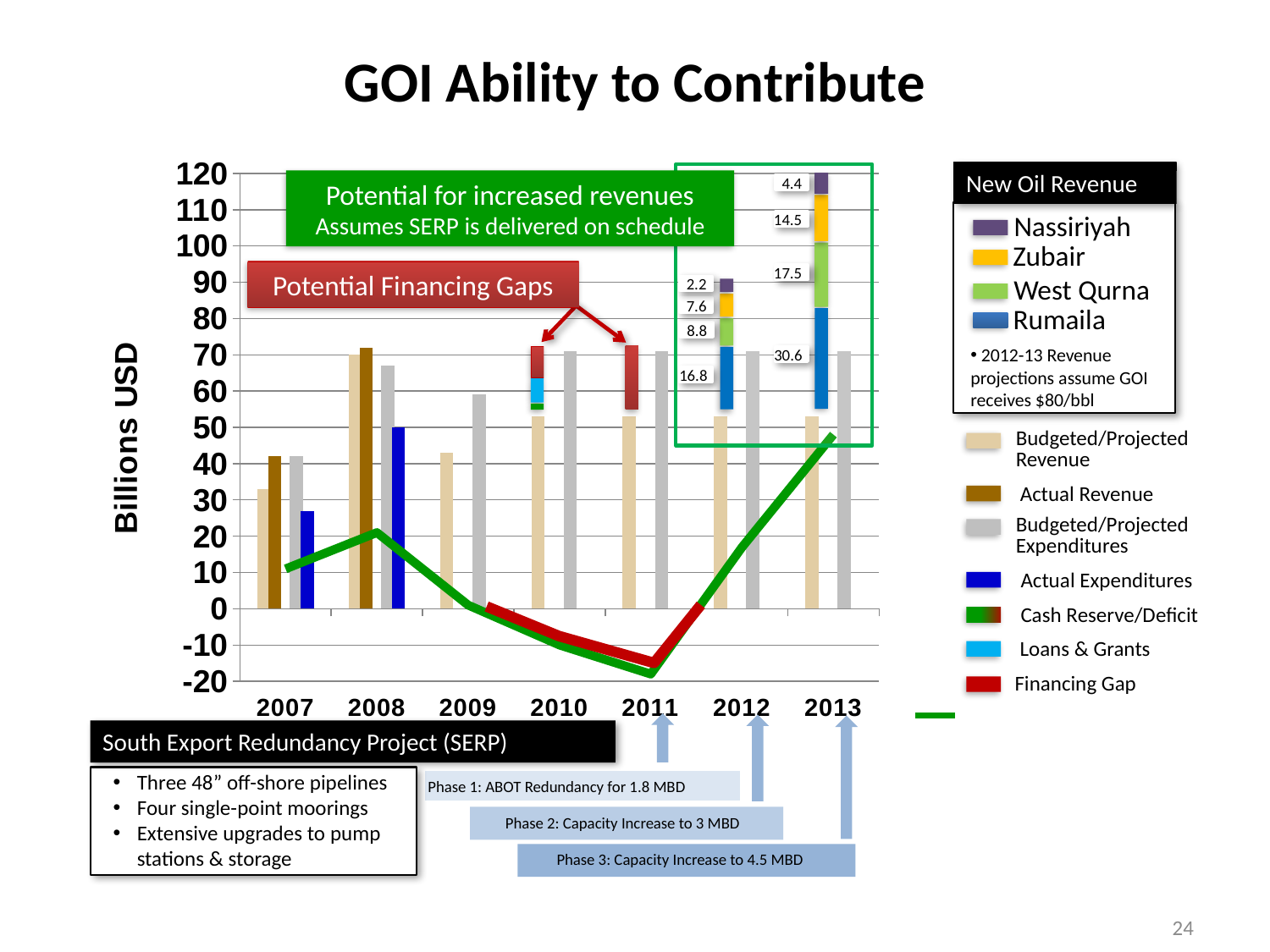
What is the label on the vertical axis of the chart? Billions USD What is the Zubair new oil revenue value shown for 2012? 7.6 What is the Rumaila new oil revenue value shown for 2013? 30.6 Which field contributes the largest new oil revenue in 2013? Rumaila By how much does the Rumaila value in 2013 exceed the Rumaila value in 2012? 13.8 Which field contributes the smallest new oil revenue in 2012? Nassiriyah What is the Nassiriyah new oil revenue value shown for 2013? 4.4 Is the Budgeted/Projected Expenditures value for 2010 greater or less than 60? greater In 2013, which is larger: the Zubair value or the West Qurna value? West Qurna What is the West Qurna new oil revenue value shown for 2012? 8.8 How many years are shown along the x axis of the chart? 7 What is the total of the 2013 new oil revenue stacked bar (Rumaila, West Qurna, Zubair and Nassiriyah)? 67